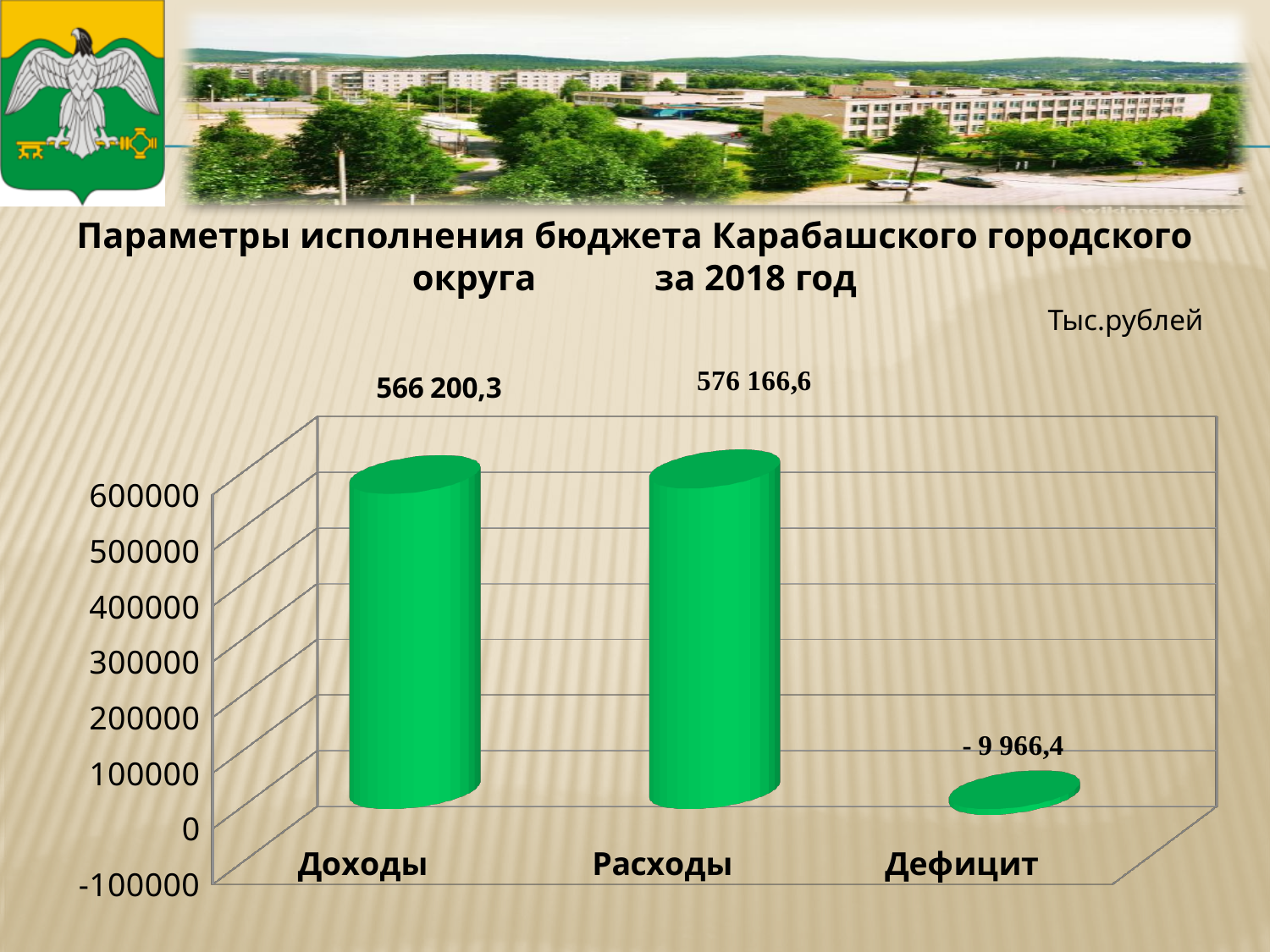
What is the value for Расходы? 576 166,6 Which category has the lowest value? Дефицит What is the value for Доходы? 566 200,3 Which is larger, Доходы or Расходы? Расходы What kind of chart is shown on the slide? bar chart How many categories are shown on the chart? 3 Which category has the highest value? Расходы Is the value for Доходы greater or less than 500000? greater What is the value for Дефицит? - 9 966,4 Is the value for Дефицит greater or less than 100000? less In what units are the chart values given? Тыс.рублей For which year does the chart show the budget parameters? 2018